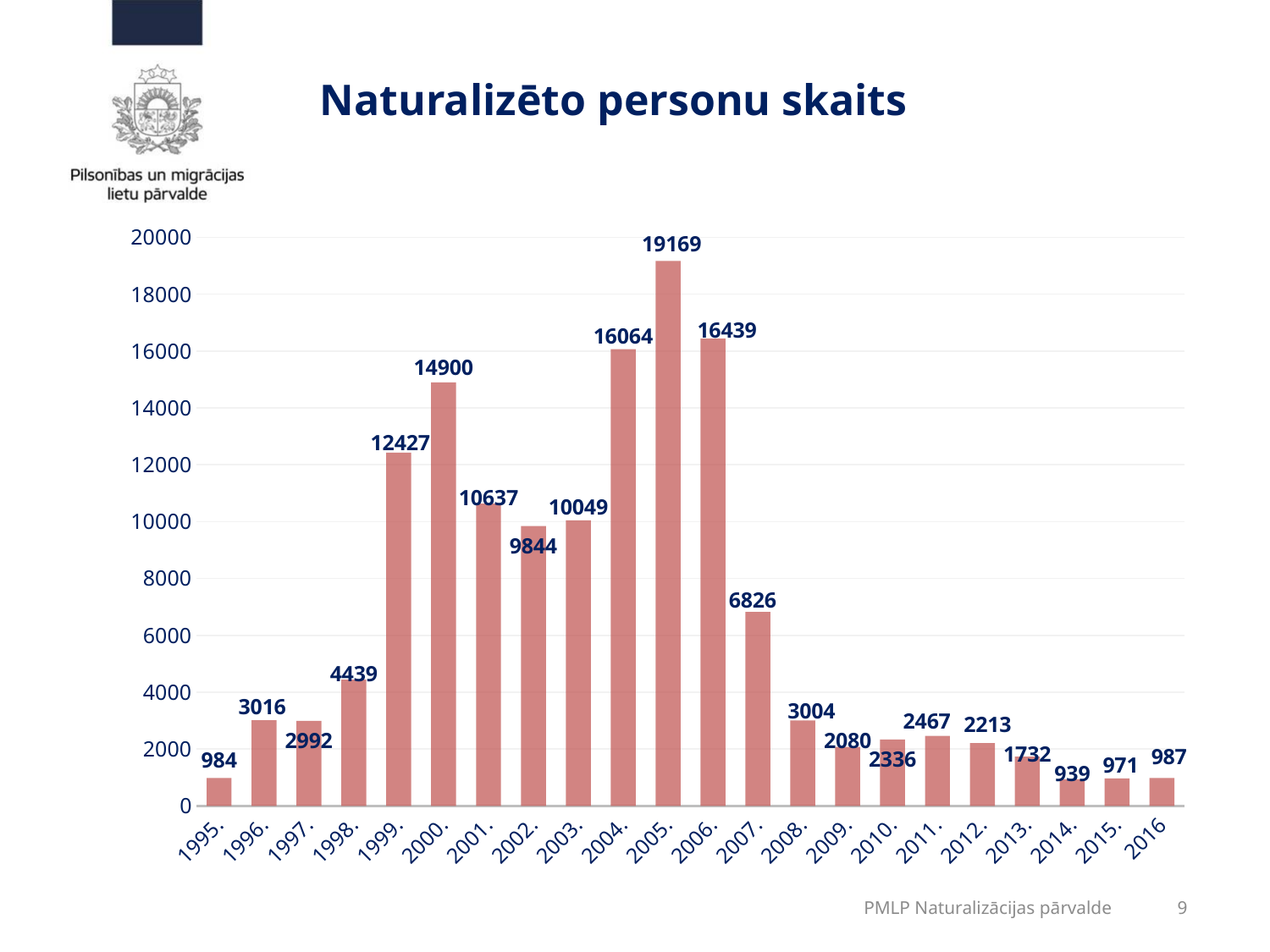
How many naturalized persons are shown for 2005? 19169 Do the values rise or fall from 2005 to 2009? fall Which year has the highest value? 2005 Which year has the larger value, 2006 or 2004? 2006 What is the value for 2016? 987 How many years are shown on the x axis? 22 Which year has the lowest value? 2014 Is the value for 2007 greater or less than 6000? greater What type of chart is shown on the slide? bar chart What is the title of the chart? Naturalizēto personu skaits What is the value for 1999? 12427 What is the difference between the values for 2005 and 2004? 3105